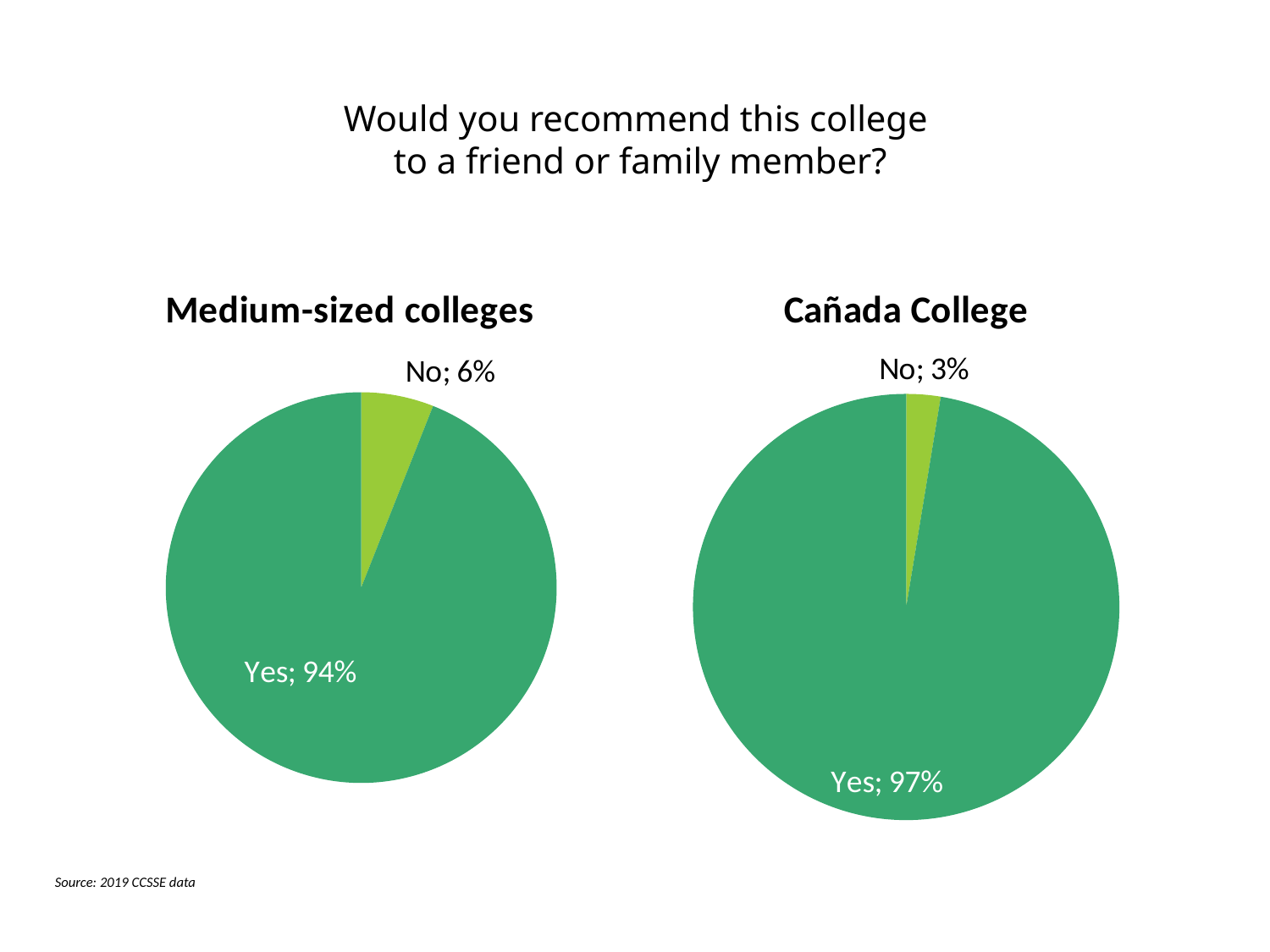
How many slices does the Cañada College chart have? 2 Which chart has the larger No share, Medium-sized colleges or Cañada College? Medium-sized colleges In the Cañada College chart, which slice is the largest? Yes What type of chart is used on this slide? Pie chart What is the difference between the Yes share for Cañada College and the Yes share for Medium-sized colleges? 3% What question is shown at the top of the slide? Would you recommend this college to a friend or family member? In the Medium-sized colleges chart, what percentage answered No? 6% What is the title of the chart on the right? Cañada College In the Medium-sized colleges chart, which slice is the smallest? No In the Medium-sized colleges chart, what percentage answered Yes? 94% In the Cañada College chart, what percentage answered Yes? 97% In the Cañada College chart, what percentage answered No? 3%